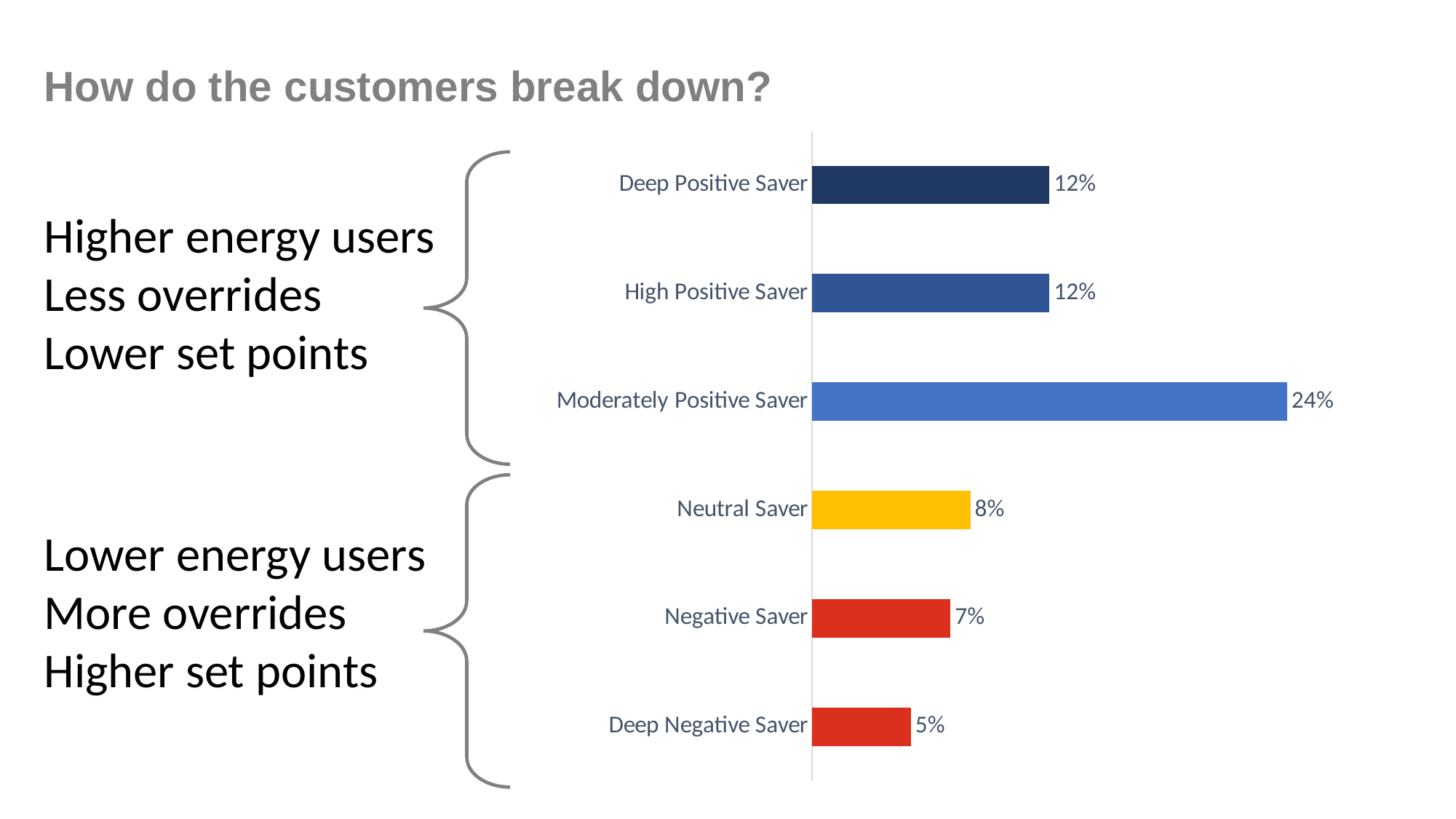
Which category has the highest value? Moderately Positive Saver Which category has the lowest value? Deep Negative Saver What is the difference between Moderately Positive Saver and Deep Positive Saver? 12% How many categories are shown in the chart? 6 What is the value for Deep Negative Saver? 5% What is the value for Negative Saver? 7% What kind of chart is shown on the slide? Bar chart What is the value for Neutral Saver? 8% Which is larger, Neutral Saver or Negative Saver? Neutral Saver What colour is the Neutral Saver bar? Yellow What is the difference between Neutral Saver and Deep Negative Saver? 3% What is the value for Moderately Positive Saver? 24%